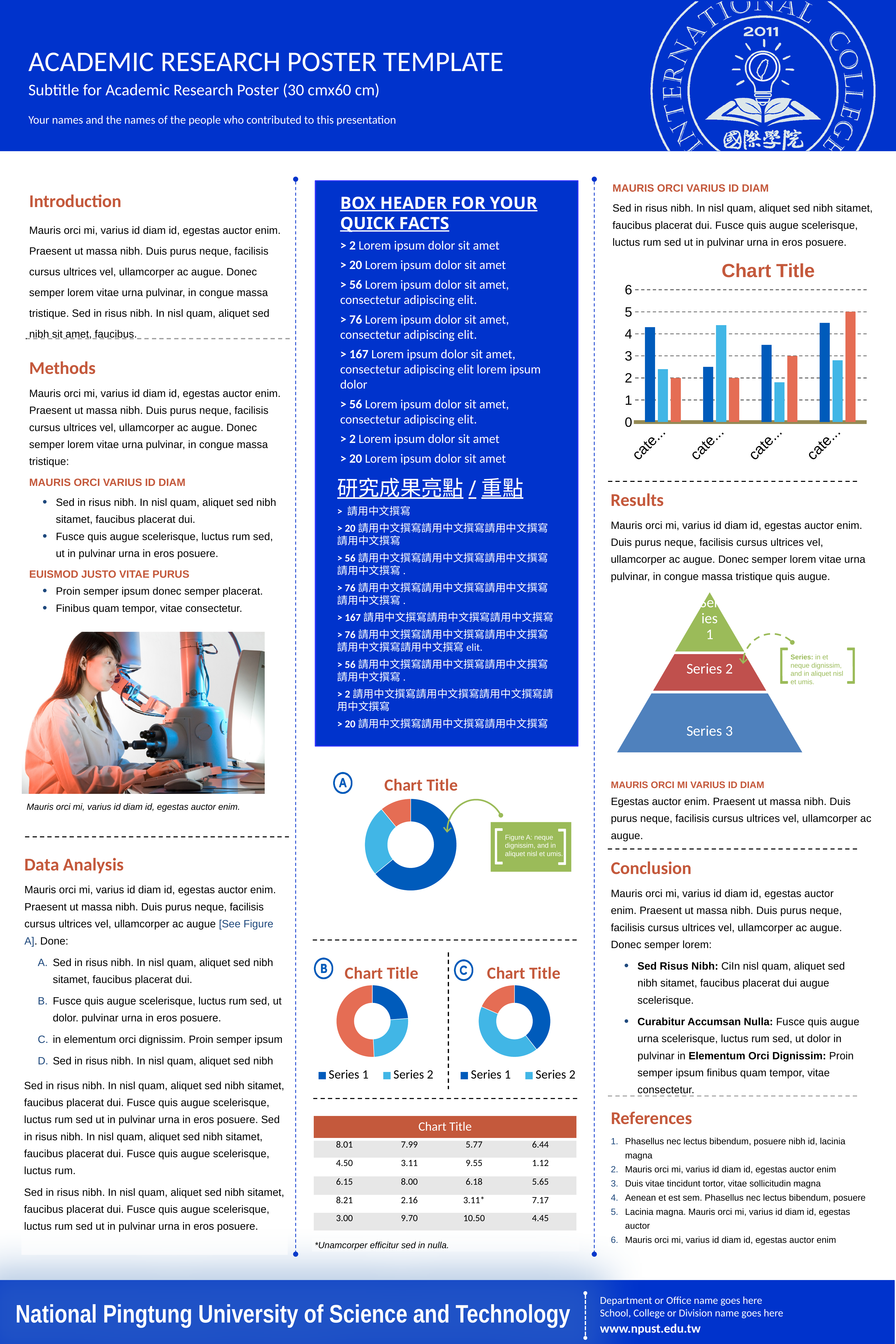
In the bar chart in the top right column, is the tallest bar greater or less than 4? greater How many slices does chart A in the middle column have? 3 In the bar chart in the top right column, what is the highest value shown on the vertical axis? 6 How many series does the legend of chart B list? 2 In the bar chart in the top right column, how many bars are there in each category group? 3 How many slices does chart C in the middle column have? 3 How many series does the legend of chart C list? 2 In chart B, which legend entry is shown in dark blue? Series 1 What kind of chart is chart A in the middle column? doughnut chart What kind of chart is the chart titled "Chart Title" in the top right column of the poster? bar chart In the bar chart in the top right column, is the shortest bar greater or less than 3? less